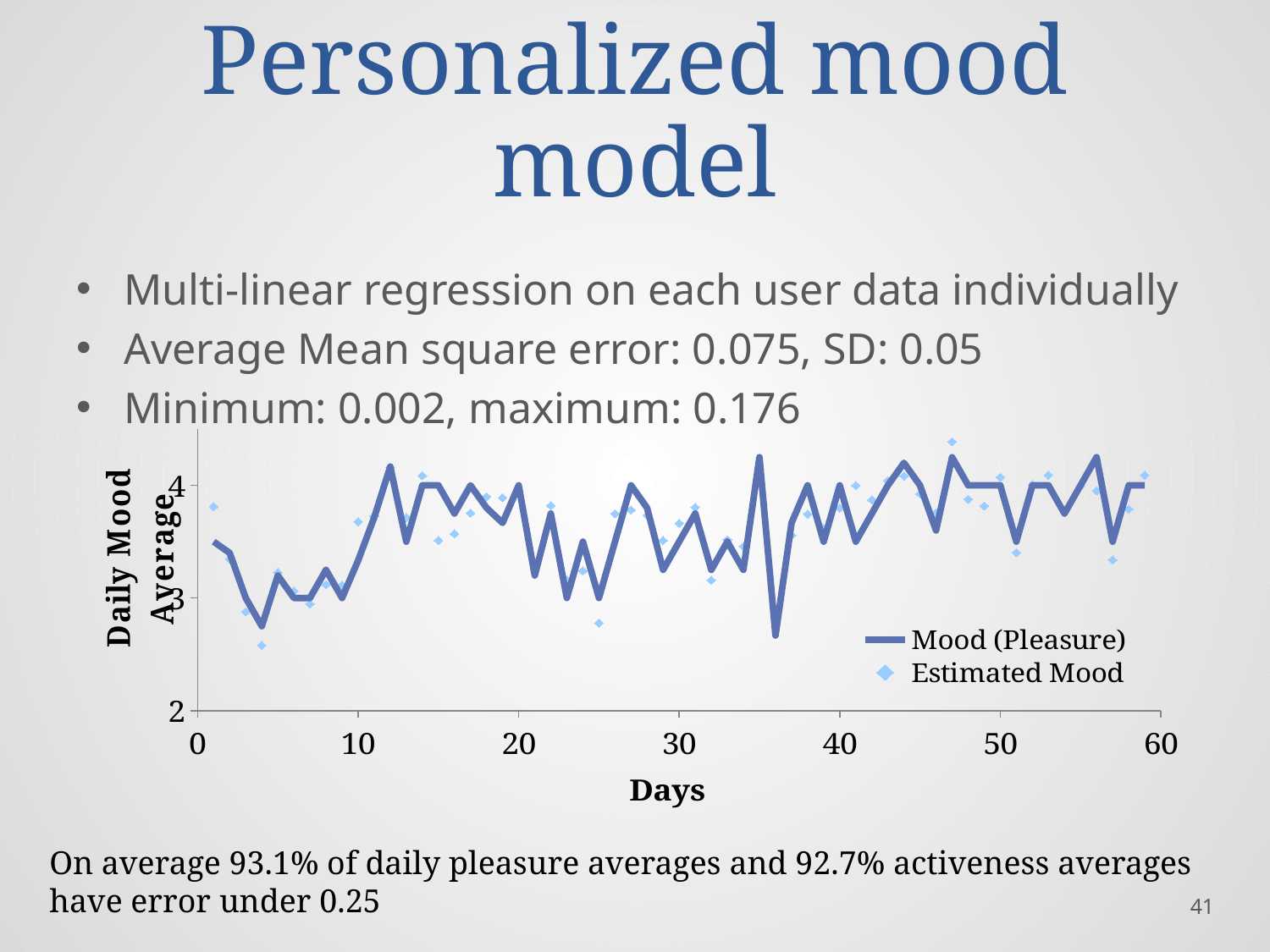
What is the title of the chart's x axis? Days Is the Mood (Pleasure) value at day 36 greater or less than 3? less Is the Mood (Pleasure) value at day 12 greater or less than 4? greater Which is larger, the Mood (Pleasure) value at day 12 or at day 36? day 12 How many series does the chart legend list? 2 Is the Estimated Mood value at day 47 greater or less than 4? greater What are the two series named in the chart legend? Mood (Pleasure) and Estimated Mood What kind of chart is shown on the slide? line chart